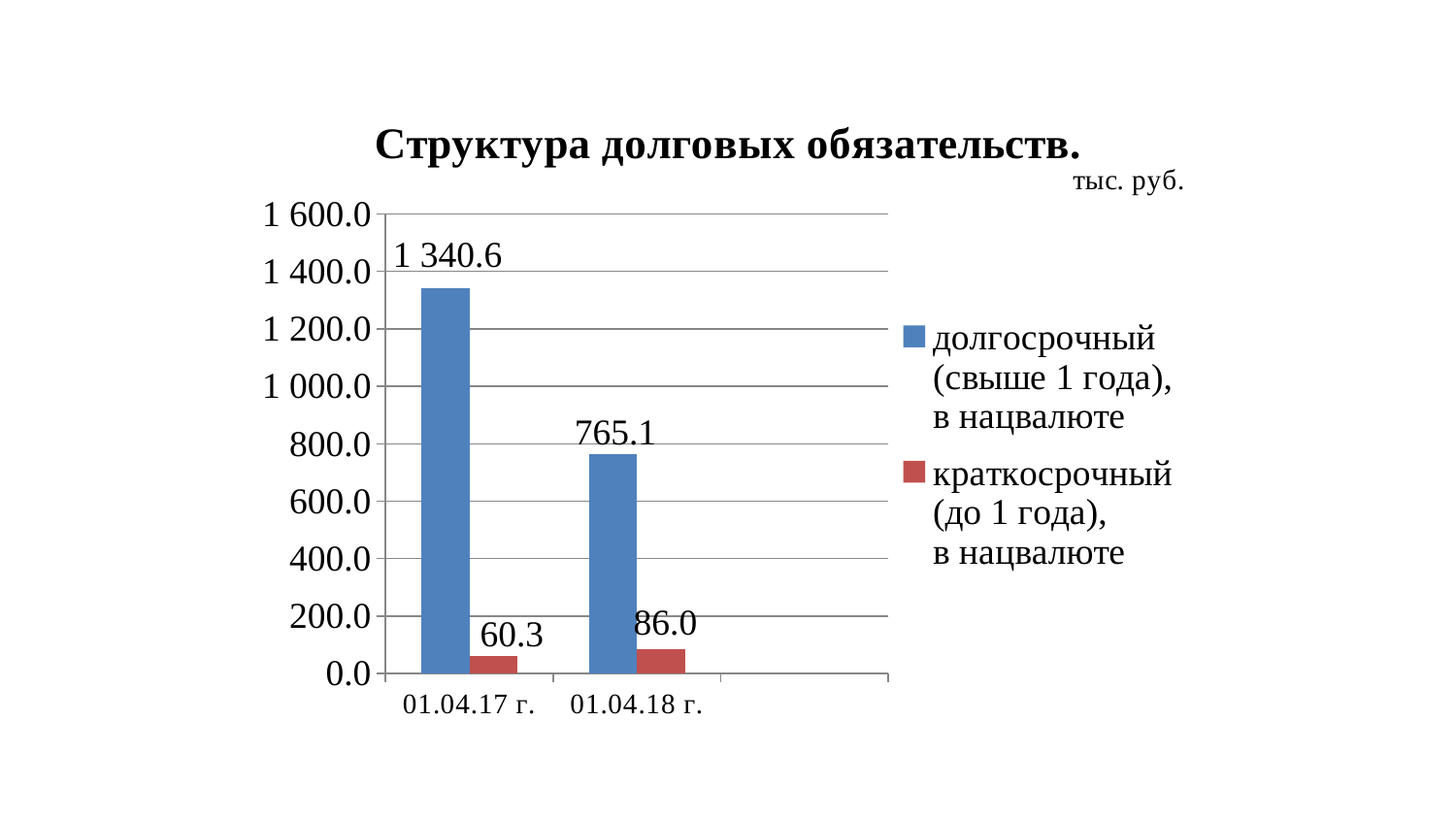
What is the value of долгосрочный (свыше 1 года), в нацвалюте for 01.04.18 г.? 765.1 What is the value of краткосрочный (до 1 года), в нацвалюте for 01.04.17 г.? 60.3 By how much did долгосрочный (свыше 1 года), в нацвалюте decrease from 01.04.17 г. to 01.04.18 г.? 575.5 What is the value of краткосрочный (до 1 года), в нацвалюте for 01.04.18 г.? 86.0 Which date has the higher value for долгосрочный (свыше 1 года), в нацвалюте? 01.04.17 г. What kind of chart is shown on the slide? Bar chart What is the title of the chart? Структура долговых обязательств. What is the difference between краткосрочный (до 1 года), в нацвалюте on 01.04.18 г. and on 01.04.17 г.? 25.7 Which date has the lower value for краткосрочный (до 1 года), в нацвалюте? 01.04.17 г. What is the value of долгосрочный (свыше 1 года), в нацвалюте for 01.04.17 г.? 1 340.6 How many series does the legend list? 2 Which is larger on 01.04.18 г.: долгосрочный (свыше 1 года), в нацвалюте or краткосрочный (до 1 года), в нацвалюте? долгосрочный (свыше 1 года), в нацвалюте